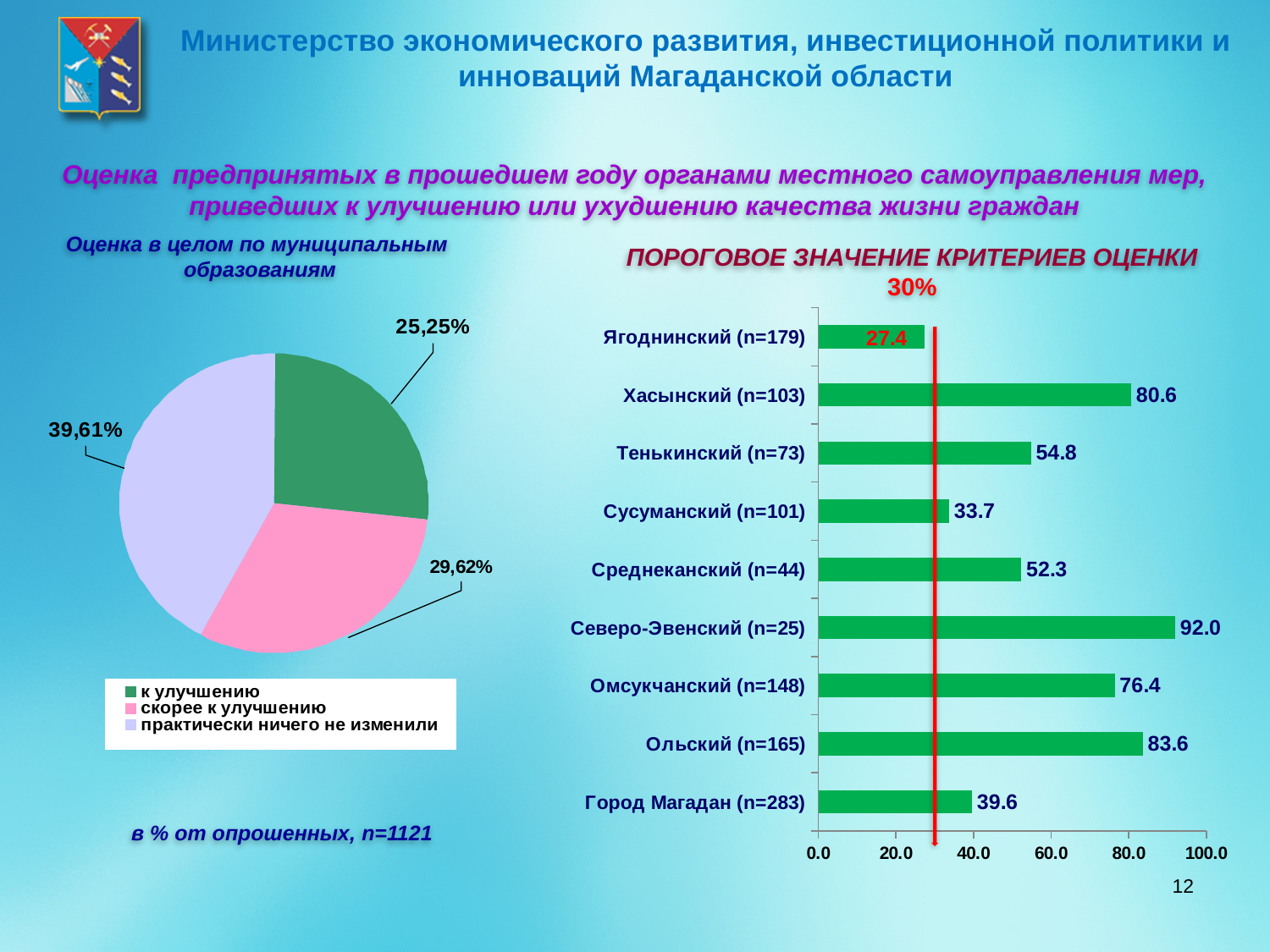
In the pie chart on the left, what share is labelled for the slice 'практически ничего не изменили'? 39,61% In the bar chart on the right, which category has the lowest value? Ягоднинский (n=179) In the bar chart on the right, what threshold value is marked by the red vertical line? 30% In the bar chart on the right, what is the value for Северо-Эвенский (n=25)? 92.0 In the bar chart on the right, which is larger: the value for Тенькинский (n=73) or Среднеканский (n=44)? Тенькинский (n=73) In the pie chart on the left, how many entries does the legend list? 3 What kind of chart is the chart on the right of the slide? Bar chart In the bar chart on the right, how many categories are plotted? 9 In the bar chart on the right, what is the value for Город Магадан (n=283)? 39.6 In the bar chart on the right, what is the difference between the values for Ольский (n=165) and Хасынский (n=103)? 3.0 In the bar chart on the right, which category has the highest value? Северо-Эвенский (n=25) In the pie chart on the left, what is the value for 'к улучшению'? 25,25%